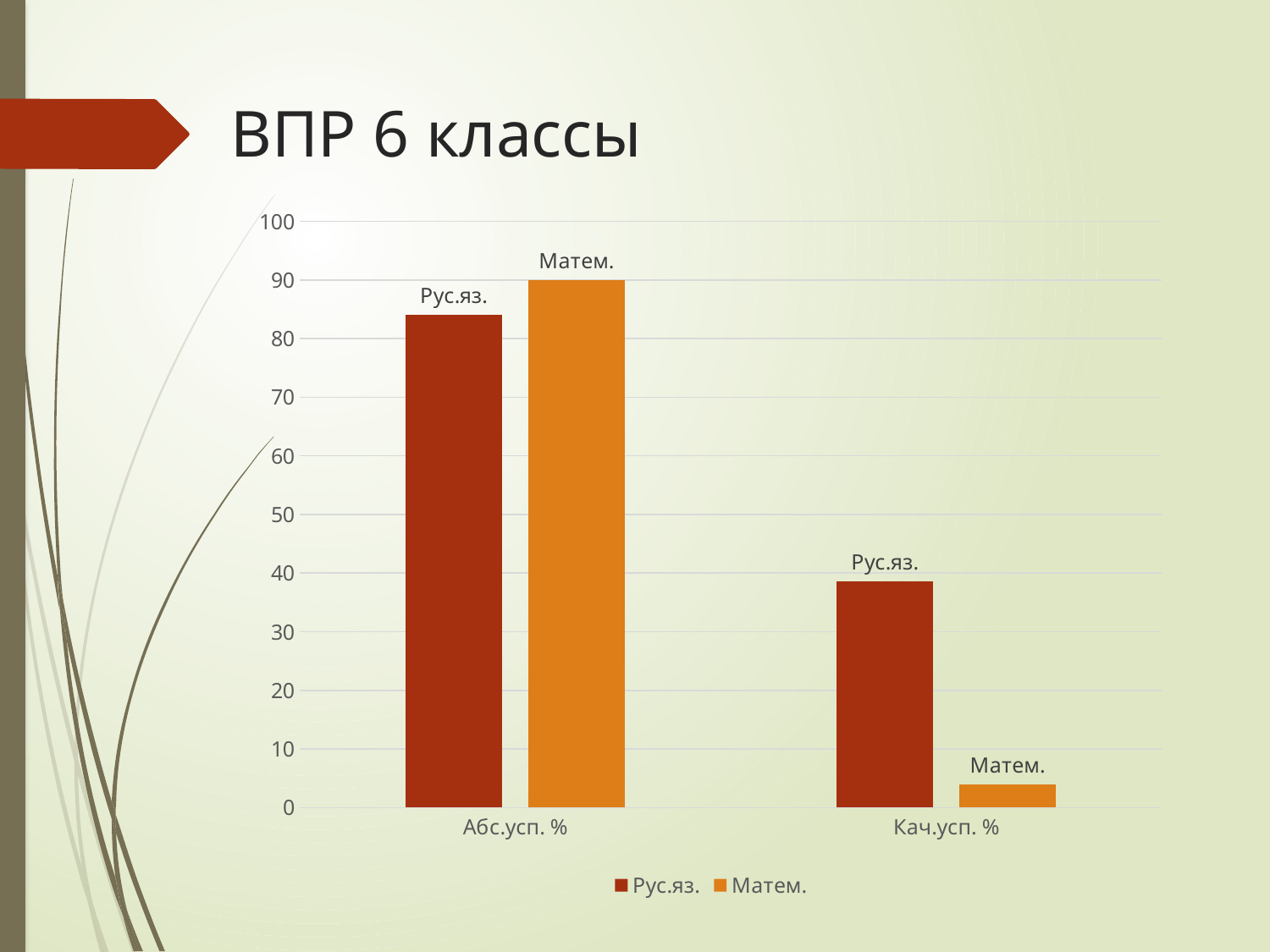
Which bar is the shortest in the chart? Матем. in Кач.усп. % In the Кач.усп. % category, which series has the larger value, Рус.яз. or Матем.? Рус.яз. Is the value for Рус.яз. in Кач.усп. % greater or less than 50? less How many series does the legend list? 2 How many categories are shown on the x axis? 2 Is the value for Рус.яз. in Абс.усп. % greater or less than 80? greater Is the value for Матем. in Кач.усп. % greater or less than 10? less What is the title of the slide? ВПР 6 классы What kind of chart is shown on the slide? bar chart Which bar is the tallest in the chart? Матем. in Абс.усп. % In the Абс.усп. % category, which series has the larger value, Рус.яз. or Матем.? Матем. Which series are listed in the legend? Рус.яз., Матем.